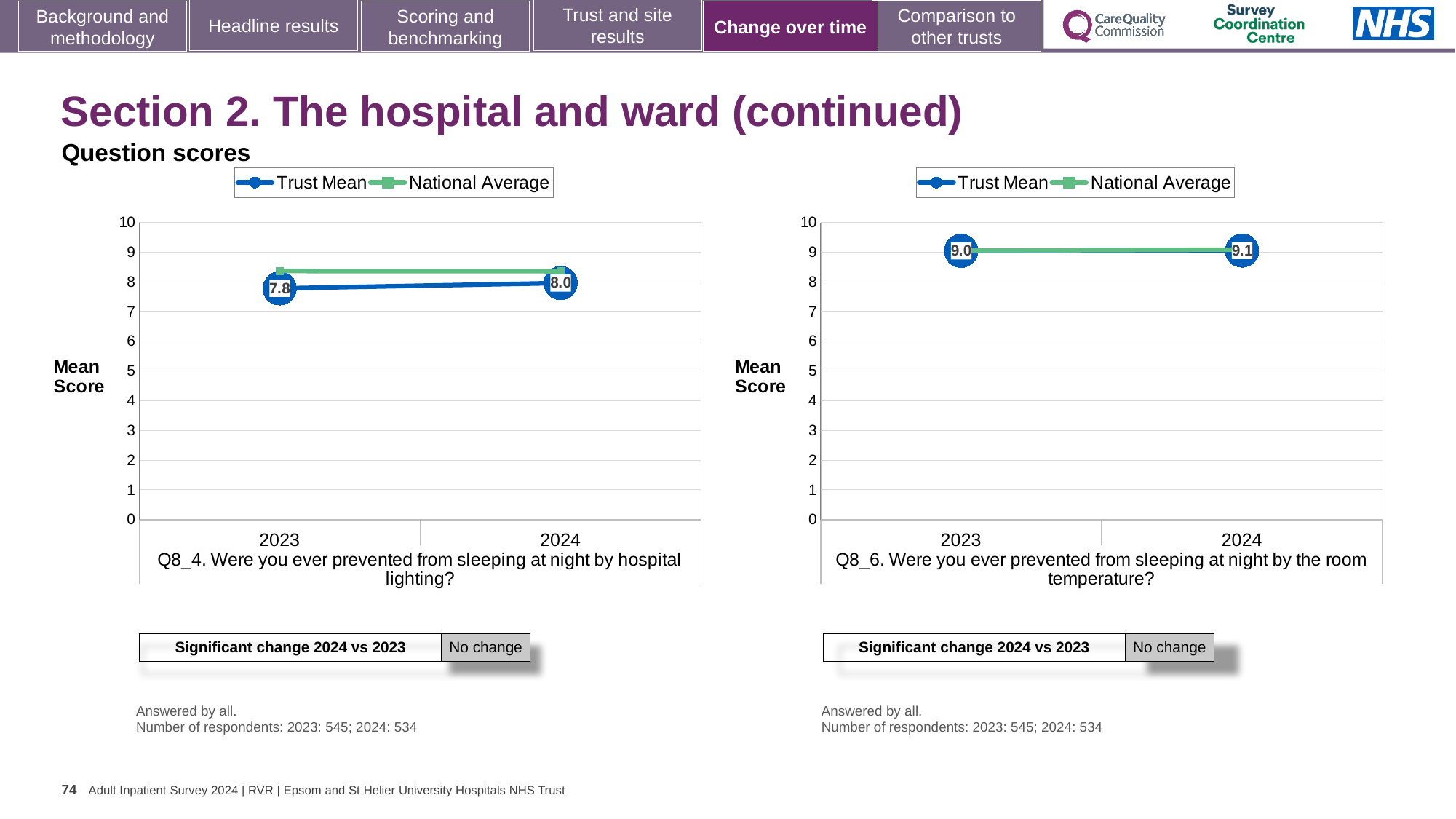
In the right chart (Q8_6, room temperature), what is the difference between the Trust Mean for 2024 and 2023? 0.1 In the left chart (Q8_4, hospital lighting), does the Trust Mean rise or fall from 2023 to 2024? rise How many series does the legend of the right chart (Q8_6, room temperature) list? 2 In the left chart (Q8_4, hospital lighting), which is higher in 2023, the Trust Mean or the National Average? National Average What kind of chart is the left chart (Q8_4, hospital lighting)? line chart How many years are plotted on the x axis of the right chart (Q8_6, room temperature)? 2 In the right chart (Q8_6, room temperature), what is the Trust Mean for 2023? 9.0 In the right chart (Q8_6, room temperature), what is the Trust Mean for 2024? 9.1 In the left chart (Q8_4, hospital lighting), what is the Trust Mean for 2023? 7.8 In the left chart (Q8_4, hospital lighting), by how much did the Trust Mean change from 2023 to 2024? 0.2 In the left chart (Q8_4, hospital lighting), is the National Average for 2023 greater or less than 8? greater In the left chart (Q8_4, hospital lighting), what is the Trust Mean for 2024? 8.0